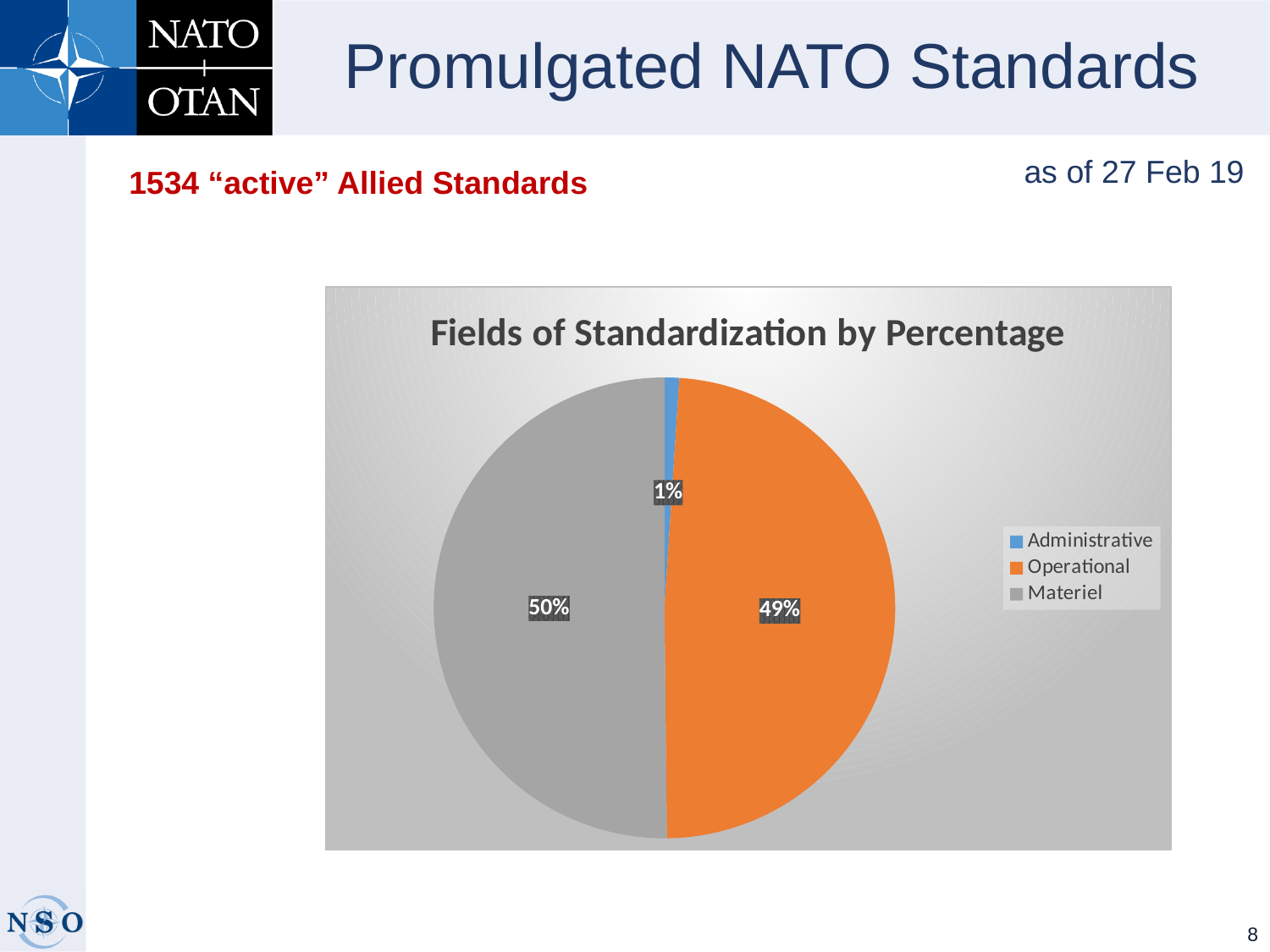
What kind of chart is shown on the slide? pie chart What is the difference in percentage points between Materiel and Operational? 1% What percentage of the pie is Materiel? 50% Which colour represents Operational in the pie chart? orange What percentage of the pie is Operational? 49% What is the difference in percentage points between Operational and Administrative? 48% Which field has the smallest share of the pie? Administrative Is the share for Administrative larger or smaller than the share for Operational? smaller What percentage of the pie is Administrative? 1% How many entries does the legend list? 3 What is the title of the chart? Fields of Standardization by Percentage How many slices does the pie chart have? 3